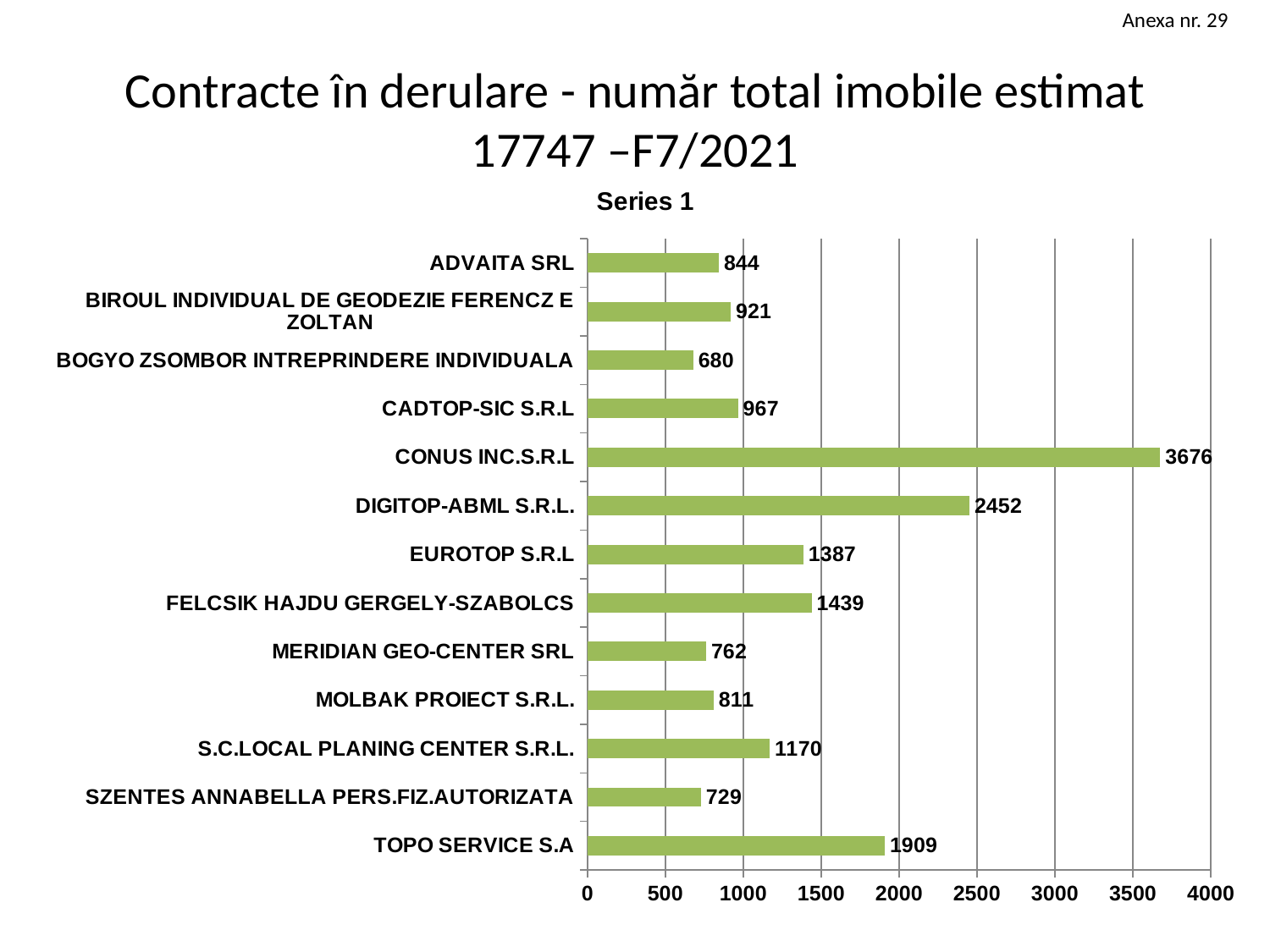
Which category has the highest value? CONUS INC.S.R.L Which is larger, the value for EUROTOP S.R.L or the value for S.C.LOCAL PLANING CENTER S.R.L.? EUROTOP S.R.L What kind of chart is shown on the slide? bar chart How many categories are shown in the chart? 13 What is the value for CONUS INC.S.R.L? 3676 What is the difference between the values for CONUS INC.S.R.L and DIGITOP-ABML S.R.L.? 1224 What is the value for BOGYO ZSOMBOR INTREPRINDERE INDIVIDUALA? 680 What is the value for TOPO SERVICE S.A? 1909 Which category has the lowest value? BOGYO ZSOMBOR INTREPRINDERE INDIVIDUALA What is the name of the series shown in the chart? Series 1 How many series does the chart show? 1 Is the value for DIGITOP-ABML S.R.L. greater or less than 2000? greater